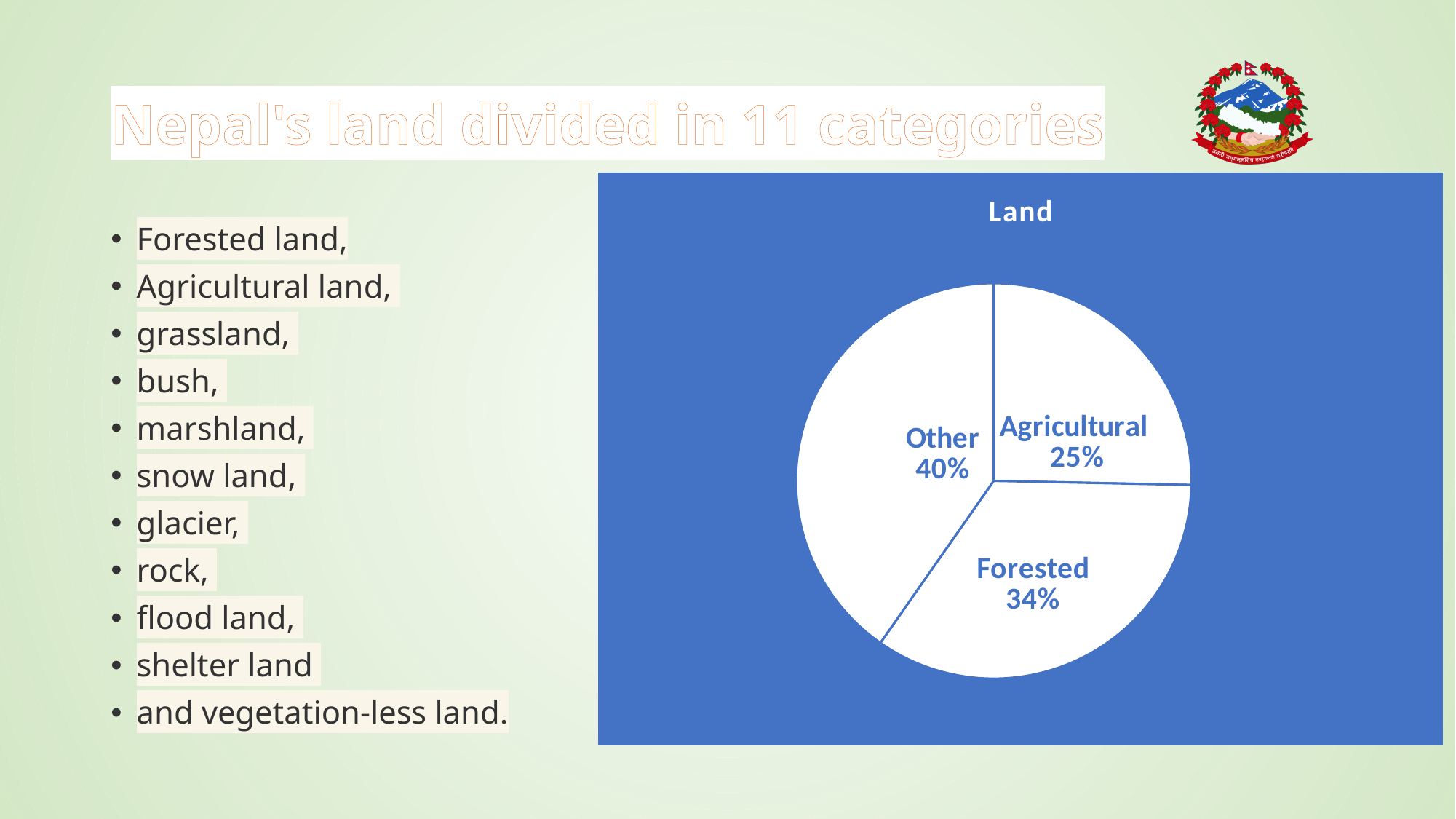
What share of the pie is Agricultural land? 25% Which is larger, the Agricultural slice or the Forested slice? Forested What is the difference in percentage points between the Other and Forested slices? 6 Which slice of the pie is the largest? Other Which slice of the pie is the smallest? Agricultural What share of the pie is Other? 40% Which is larger, the Forested slice or the Other slice? Other How many slices does the pie chart have? 3 What is the title of the chart? Land What is the difference in percentage points between the Forested and Agricultural slices? 9 What share of the pie is Forested land? 34% What kind of chart is shown on the slide? pie chart